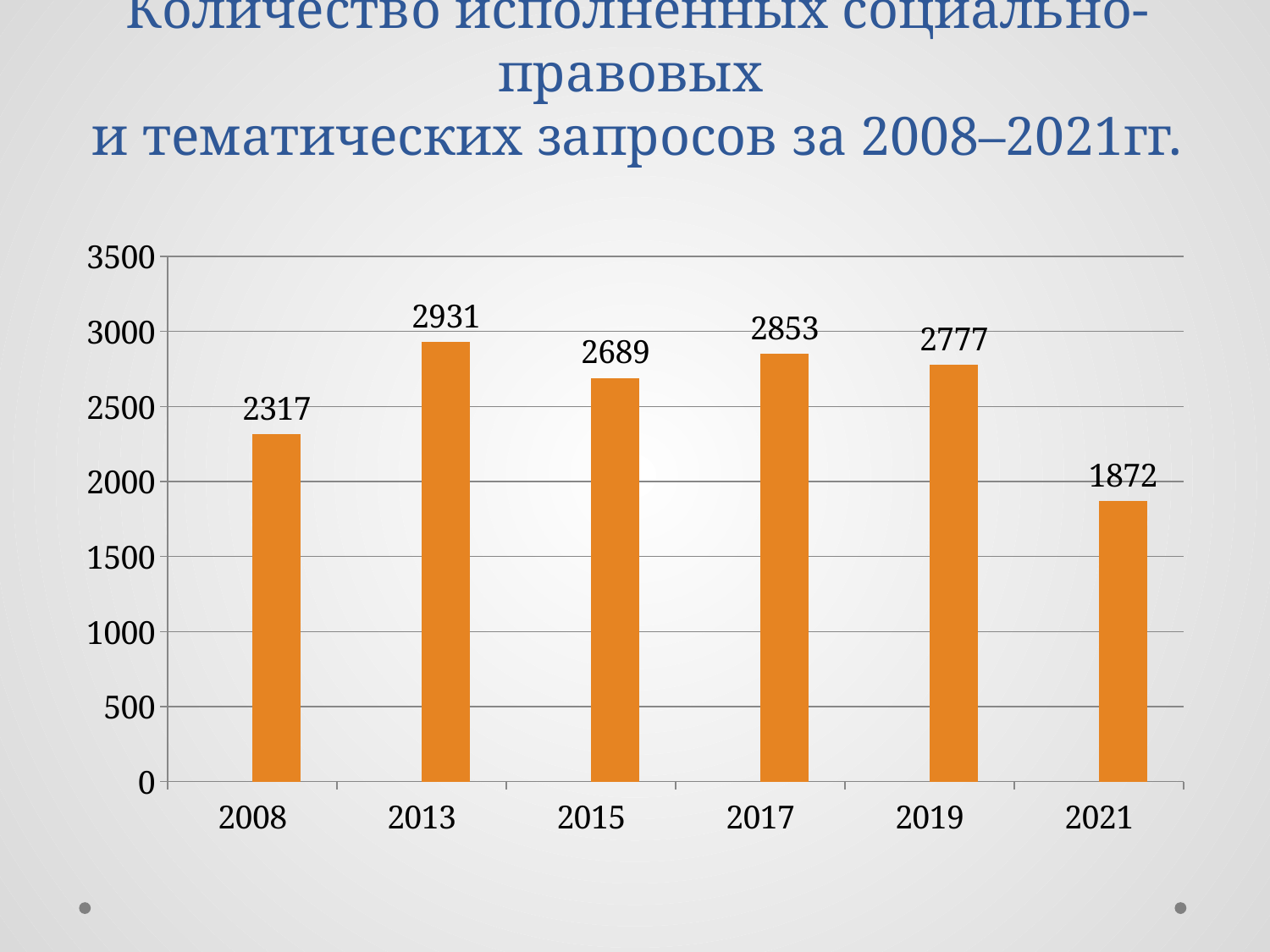
What kind of chart is shown on the slide? bar chart How many years are shown on the x axis? 6 What is the value for 2008? 2317 What colour are the bars in the chart? orange What is the difference between the values for 2013 and 2021? 1059 Which year has the highest value? 2013 Which year has the lowest value? 2021 What is the difference between the values for 2017 and 2019? 76 Which is larger, the value for 2015 or the value for 2019? 2019 Is the value for 2021 greater or less than 2000? less What is the value for 2017? 2853 What is the value for 2021? 1872